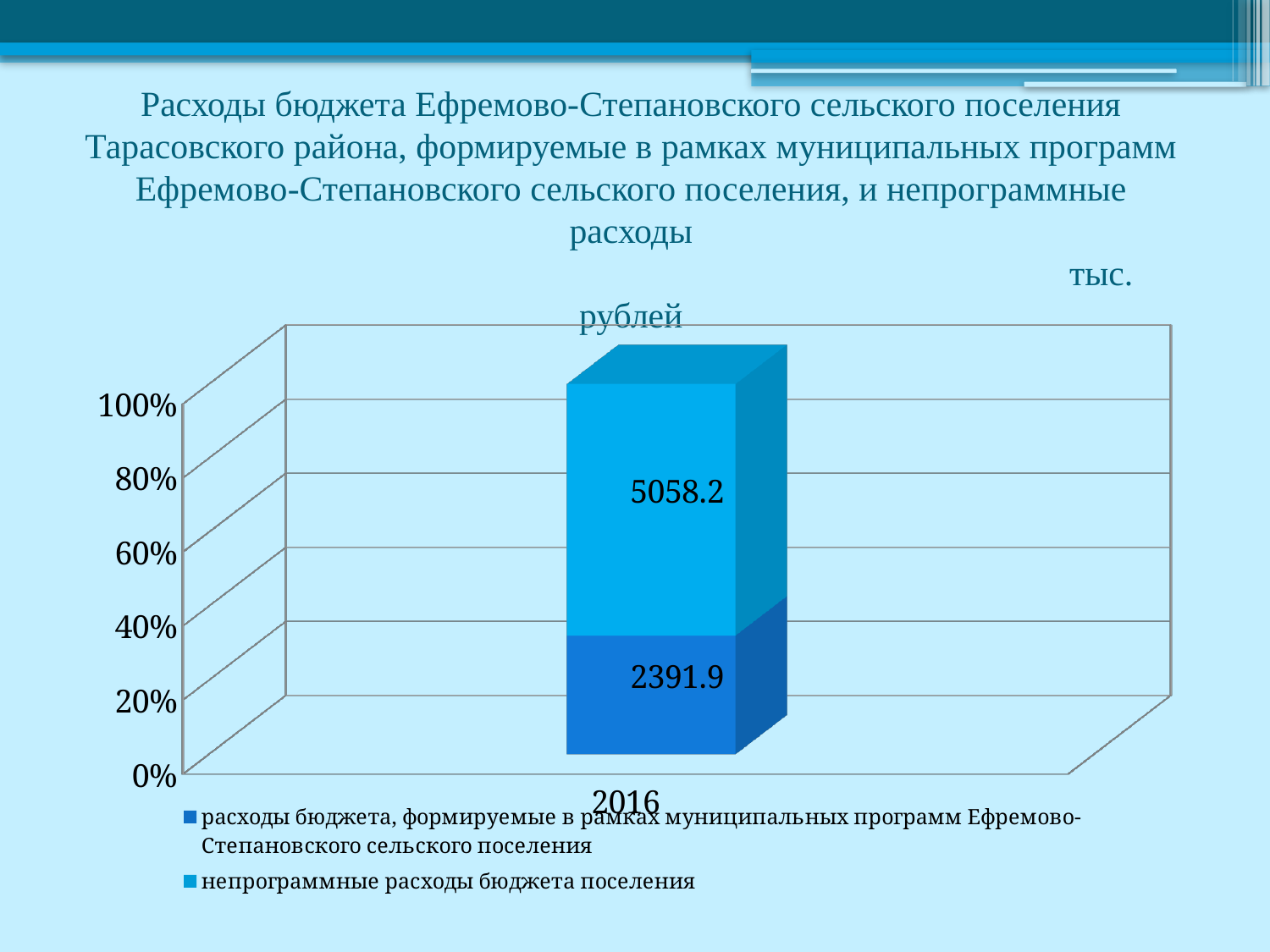
What kind of chart is shown on the slide? stacked bar chart Which year is shown on the x axis? 2016 What is the value for расходы бюджета, формируемые в рамках муниципальных программ Ефремово-Степановского сельского поселения in 2016? 2391.9 What is the value for непрограммные расходы бюджета поселения in 2016? 5058.2 What is the total of the stacked bar for 2016? 7450.1 Which series is the highest in 2016? непрограммные расходы бюджета поселения What unit is indicated above the chart? тыс. рублей How many categories are shown on the x axis? 1 Which series is the lowest in 2016? расходы бюджета, формируемые в рамках муниципальных программ Ефремово-Степановского сельского поселения What is the difference between непрограммные расходы (5058.2) and программные расходы (2391.9) in 2016? 2666.3 Which series has the larger value in 2016: программные расходы or непрограммные расходы? непрограммные расходы бюджета поселения How many series does the legend list? 2